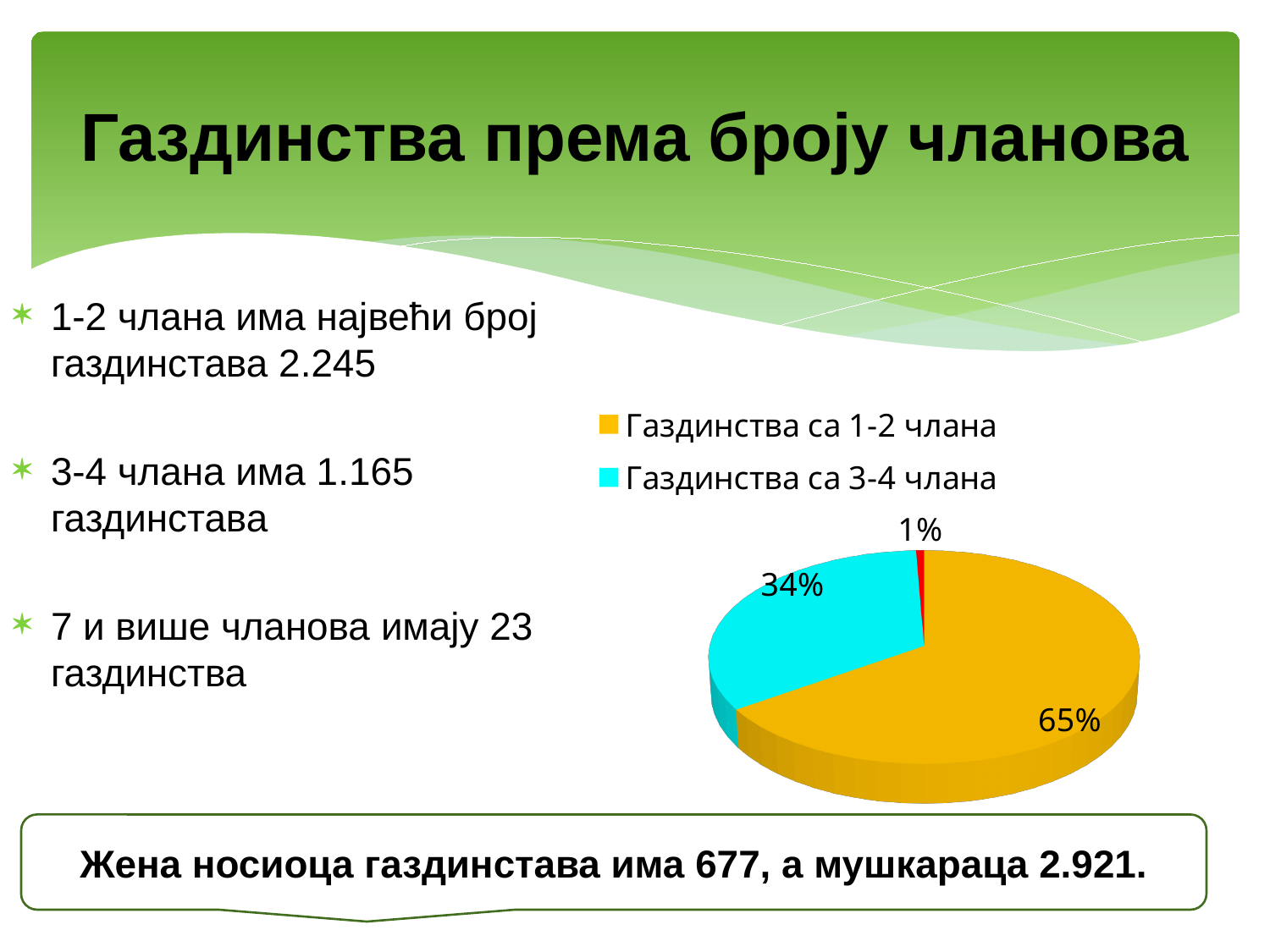
What colour is the slice for "Газдинства са 3-4 члана"? Cyan Is the share of "Газдинства са 3-4 члана" greater or less than 50%? less What colour is the slice for "Газдинства са 1-2 члана"? Yellow What share of the pie does "Газдинства са 1-2 члана" have? 65% By how many percentage points does the share of "Газдинства са 1-2 члана" exceed that of "Газдинства са 3-4 члана"? 31 percentage points Which is larger: the share of "Газдинства са 1-2 члана" or "Газдинства са 3-4 члана"? Газдинства са 1-2 члана How many slices does the pie chart have? 3 What share of the pie does "Газдинства са 3-4 члана" have? 34% What kind of chart is shown on the slide? Pie chart Which legend category has the largest slice of the pie? Газдинства са 1-2 члана What is the smallest percentage labelled on the pie chart? 1% How many entries does the chart legend list? 2